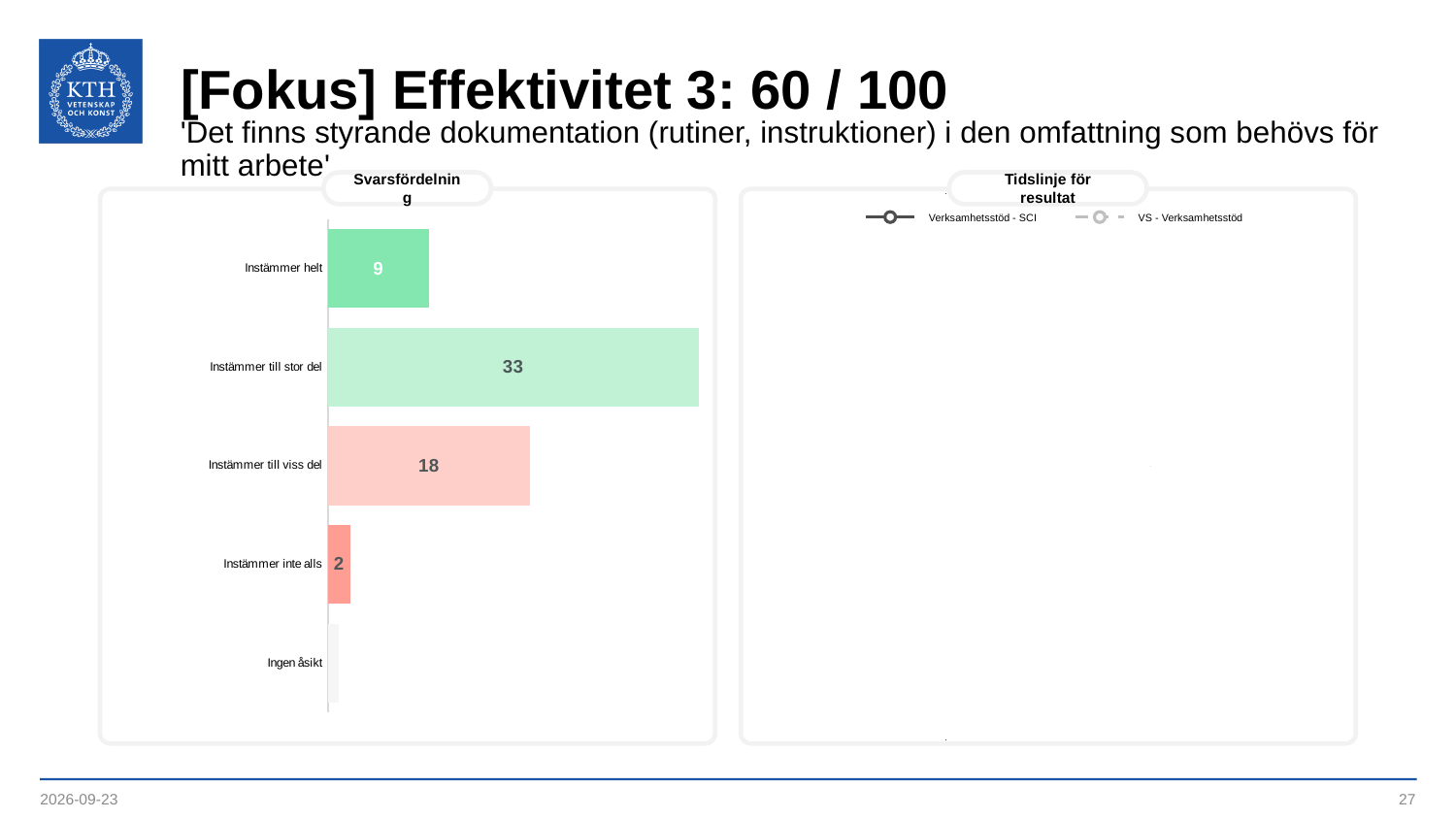
How many categories are shown in the 'Svarsfördelning' chart? 5 In the 'Svarsfördelning' chart, which is larger: 'Instämmer helt' or 'Instämmer till viss del'? Instämmer till viss del What kind of chart is the 'Svarsfördelning' chart? Bar chart In the 'Svarsfördelning' chart, what is the value for 'Instämmer helt'? 9 In the 'Svarsfördelning' chart, which category with a printed value has the lowest value? Instämmer inte alls In the 'Svarsfördelning' chart, what is the difference between 'Instämmer till stor del' and 'Instämmer till viss del'? 15 What are the legend entries of the 'Tidslinje för resultat' chart? Verksamhetsstöd - SCI and VS - Verksamhetsstöd In the 'Svarsfördelning' chart, which category has the highest value? Instämmer till stor del In the 'Svarsfördelning' chart, what is the value for 'Instämmer till stor del'? 33 How many series does the legend of the 'Tidslinje för resultat' chart list? 2 In the 'Svarsfördelning' chart, what is the value for 'Instämmer till viss del'? 18 In the 'Svarsfördelning' chart, what is the value for 'Instämmer inte alls'? 2